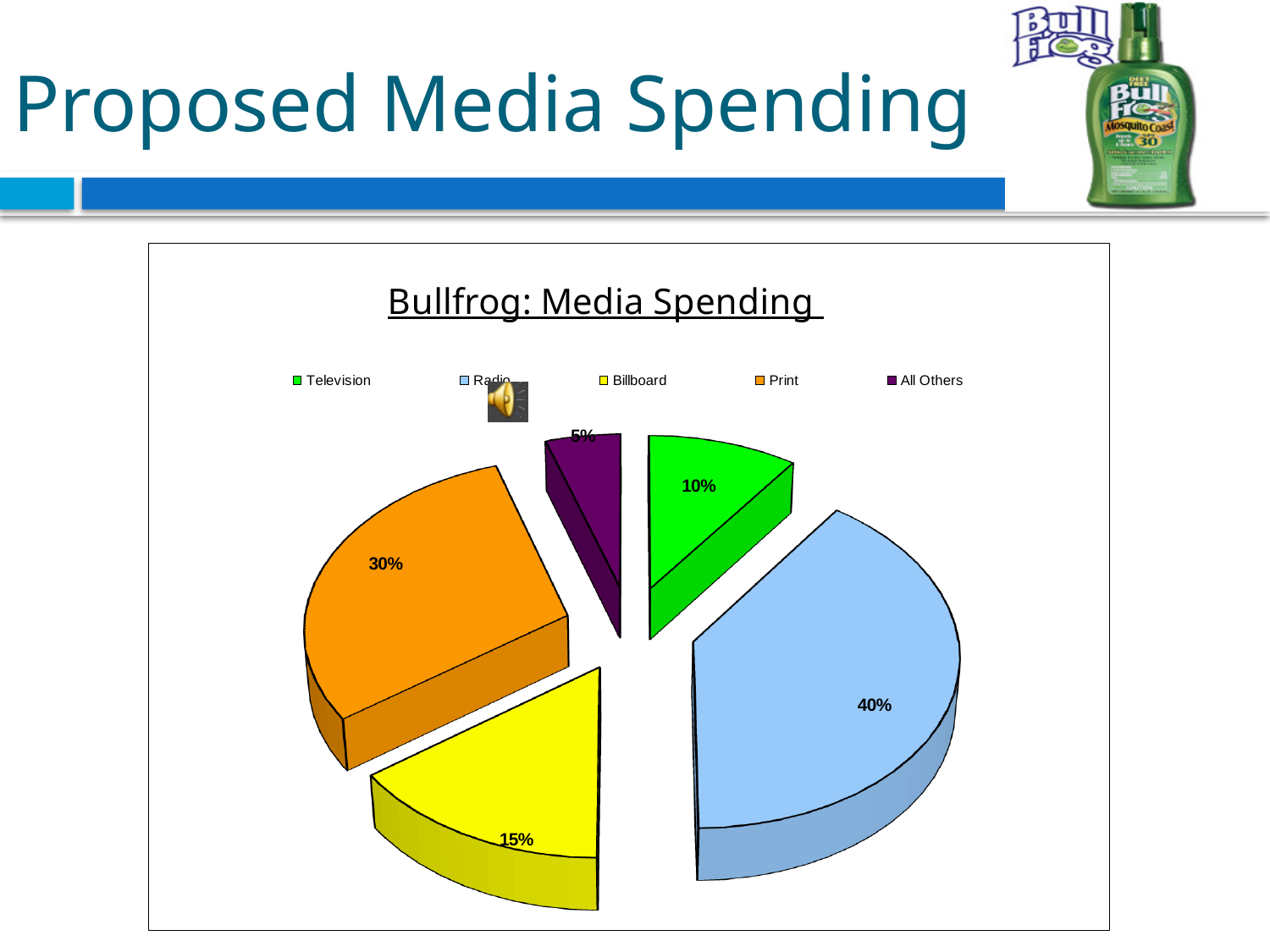
What share of media spending goes to All Others? 5% What share of media spending goes to Television? 10% Which media category has the smallest share of spending? All Others What is the title of the chart? Bullfrog: Media Spending What is the difference in percentage points between the Radio and Print shares? 10% What share of media spending goes to Radio? 40% Which has a larger share of spending, Billboard or Television? Billboard What share of media spending goes to Billboard? 15% What share of media spending goes to Print? 30% Which media category has the largest share of spending? Radio How many media categories does the legend list? 5 What type of chart is shown on the slide? Pie chart